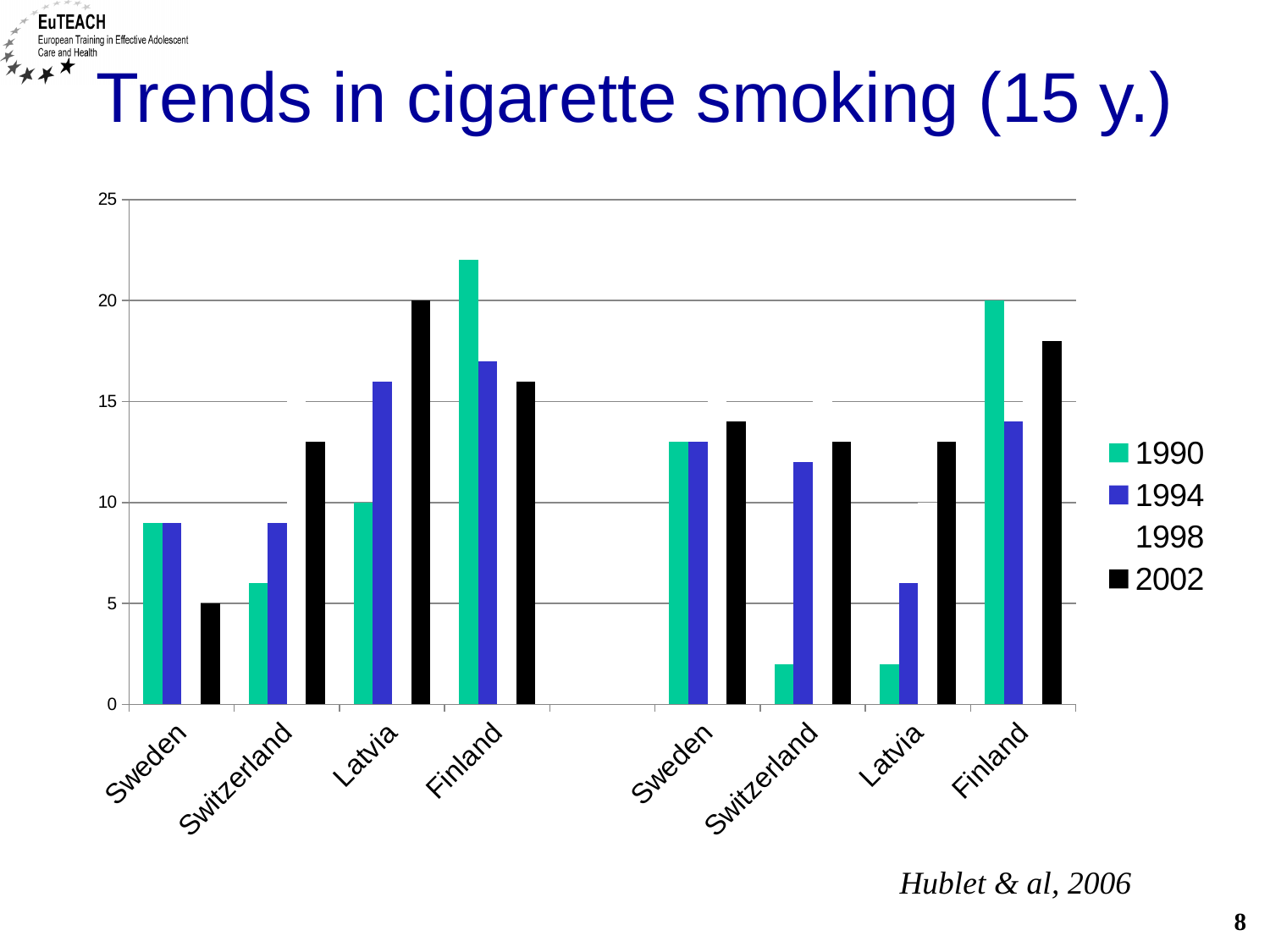
In the right group of countries, is the 1990 value for Switzerland greater or less than 5? less What colour represents the 2002 series in the legend? black How many country labels are shown along the x axis? 8 In the left group of countries, what is the 2002 value for Sweden? 5 What is the title of the slide? Trends in cigarette smoking (15 y.) What kind of chart is shown on the slide? bar chart In the left group of countries, which is larger: the 1994 value for Latvia or the 1994 value for Switzerland? Latvia In the left group of countries, what is the 2002 value for Latvia? 20 In the left group of countries, do the values for Switzerland rise or fall from 1990 to 2002? rise In the left group of countries, is the 1990 value for Finland greater or less than 20? greater How many series does the legend list? 4 In the left group of countries, which country has the highest 1990 value? Finland